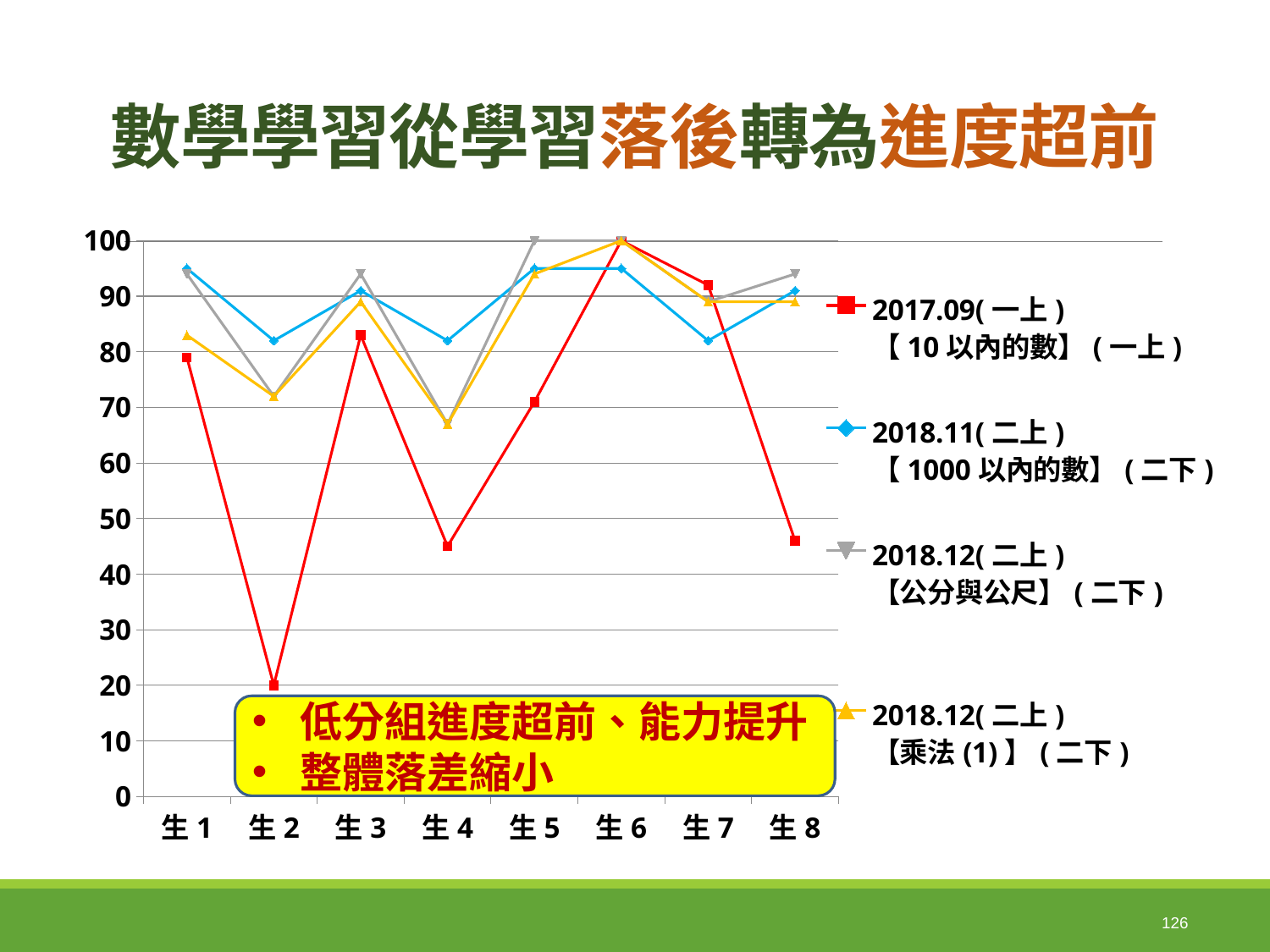
How many students (categories) are shown on the x axis? 8 Is the value for 生1 in the 2017.09(一上) series greater or less than 70? greater Which student has the lowest value in the 2017.09(一上) series? 生2 What is the value for 生5 in the 2018.12(二上)【公分與公尺】 series? 100 How many series does the legend list? 4 What is the value for 生6 in the 2017.09(一上) series? 100 At 生4, which series has the larger value: 2017.09(一上) or 2018.11(二上)? 2018.11(二上) Is the value for 生8 in the 2017.09(一上) series greater or less than 50? less Which series is drawn in red? 2017.09(一上)【10以內的數】(一上) What is the value for 生2 in the 2017.09(一上) series? 20 Which student has the highest value in the 2017.09(一上) series? 生6 What kind of chart is shown on the slide? line chart